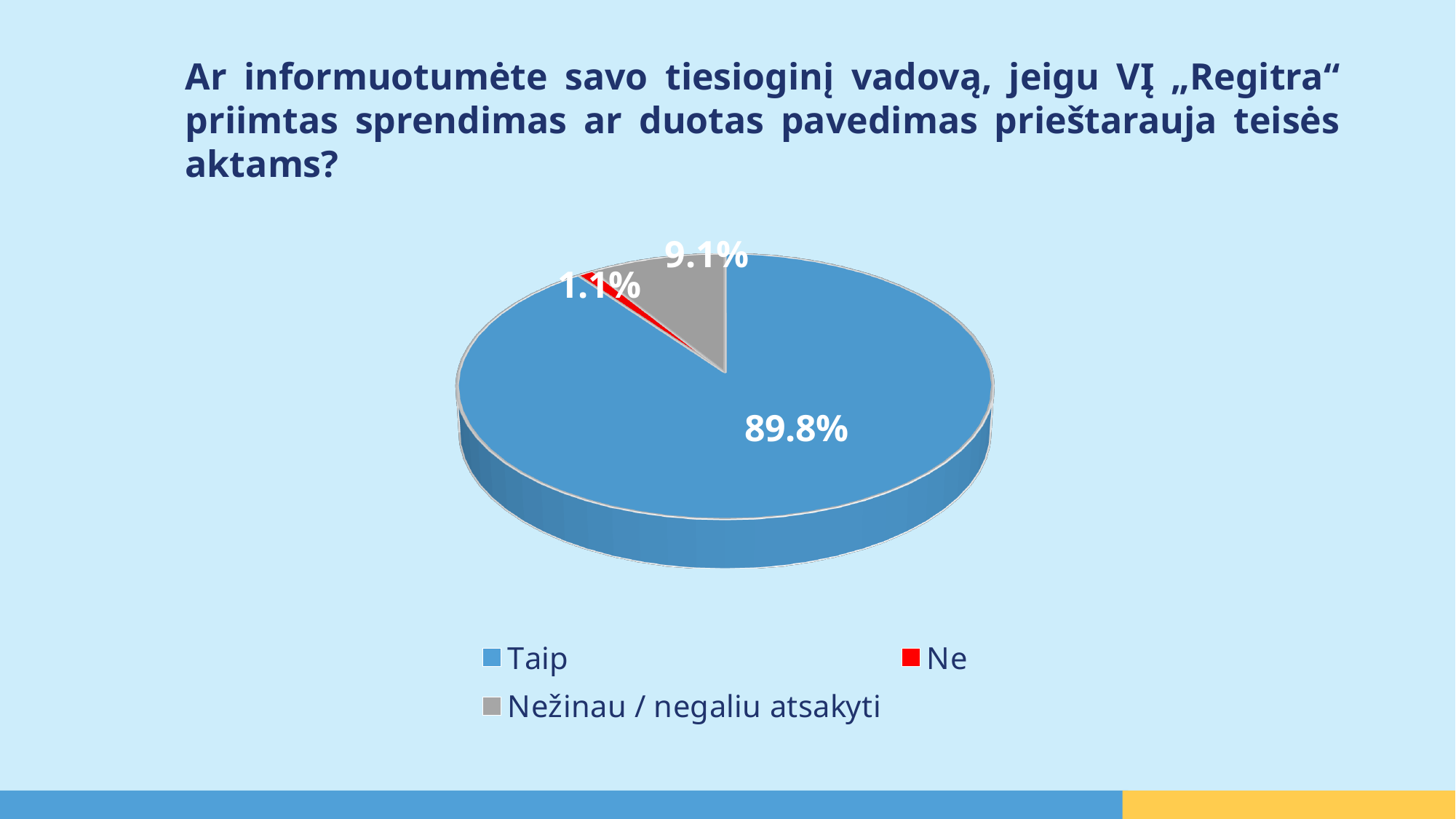
What colour is the slice for "Ne"? Red Which is larger, the share for "Ne" or the share for "Nežinau / negaliu atsakyti"? Nežinau / negaliu atsakyti What percentage of respondents answered "Nežinau / negaliu atsakyti"? 9.1% How many slices does the pie chart have? 3 Which answer has the smallest share of the pie? Ne How many entries does the legend list? 3 What percentage of respondents answered "Ne"? 1.1% What is the difference in percentage points between "Taip" and "Nežinau / negaliu atsakyti"? 80.7 What kind of chart is shown on the slide? Pie chart What percentage of respondents answered "Taip"? 89.8% What is the difference in percentage points between "Nežinau / negaliu atsakyti" and "Ne"? 8.0 Which answer has the largest share of the pie? Taip